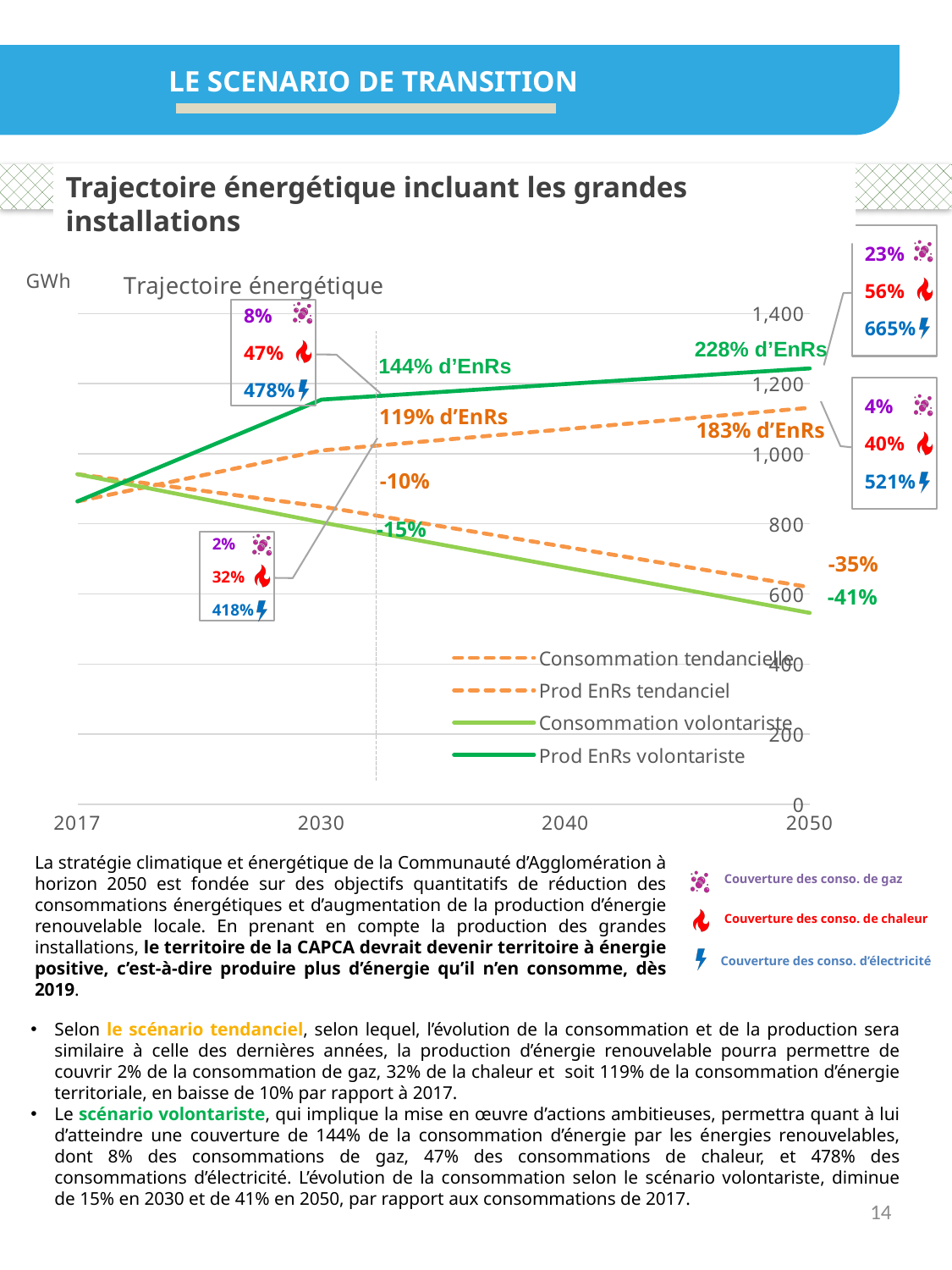
Is the value for Prod EnRs volontariste in 2050 greater or less than 1,000? greater What type of chart is shown on the slide? line chart In 2050, which is larger: Prod EnRs volontariste or Prod EnRs tendanciel? Prod EnRs volontariste Which series has the highest value in 2050? Prod EnRs volontariste In 2050, which is larger: Prod EnRs volontariste or Consommation volontariste? Prod EnRs volontariste What percentage label is printed next to the Prod EnRs volontariste line at 2050? 228% d'EnRs Is the value for Consommation volontariste in 2050 greater or less than 800? less What unit is indicated for the y axis of the chart? GWh Does the Consommation volontariste line rise or fall from 2017 to 2050? fall How many series does the chart legend list? 4 How many years are labelled on the x axis of the chart? 4 What is the title of the chart? Trajectoire énergétique